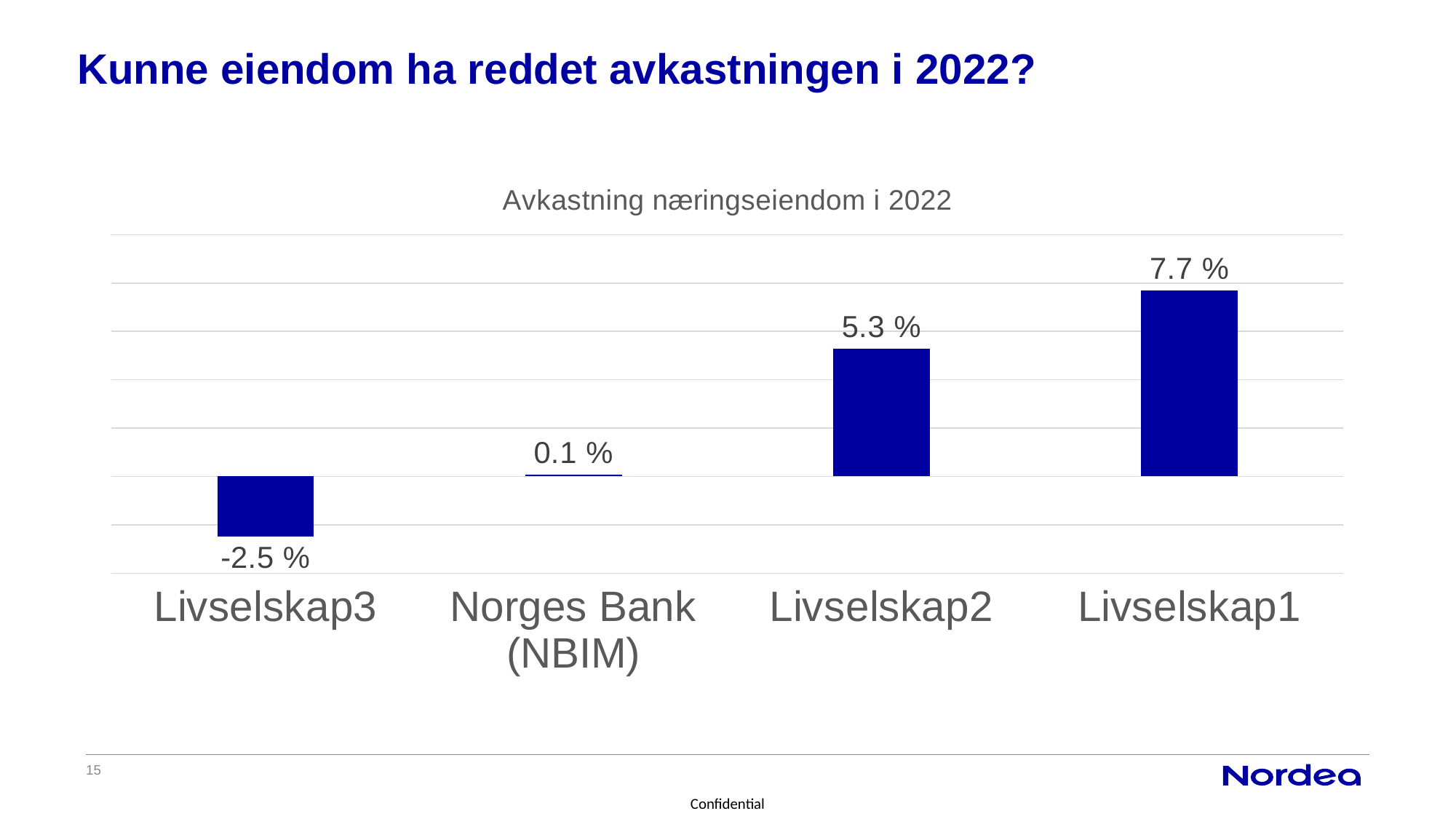
How many categories are shown in the chart? 4 What is the difference between the values for Livselskap1 and Livselskap2? 2.4 % Which category has the lowest value? Livselskap3 What is the value for Livselskap2? 5.3 % What is the value for Livselskap1? 7.7 % What is the value for Norges Bank (NBIM)? 0.1 % What kind of chart is shown on the slide? Bar chart Which is larger, the value for Livselskap2 or the value for Norges Bank (NBIM)? Livselskap2 Which category has the highest value? Livselskap1 What is the value for Livselskap3? -2.5 % What is the title of the chart? Avkastning næringseiendom i 2022 Do the values rise or fall from left to right along the x axis? Rise